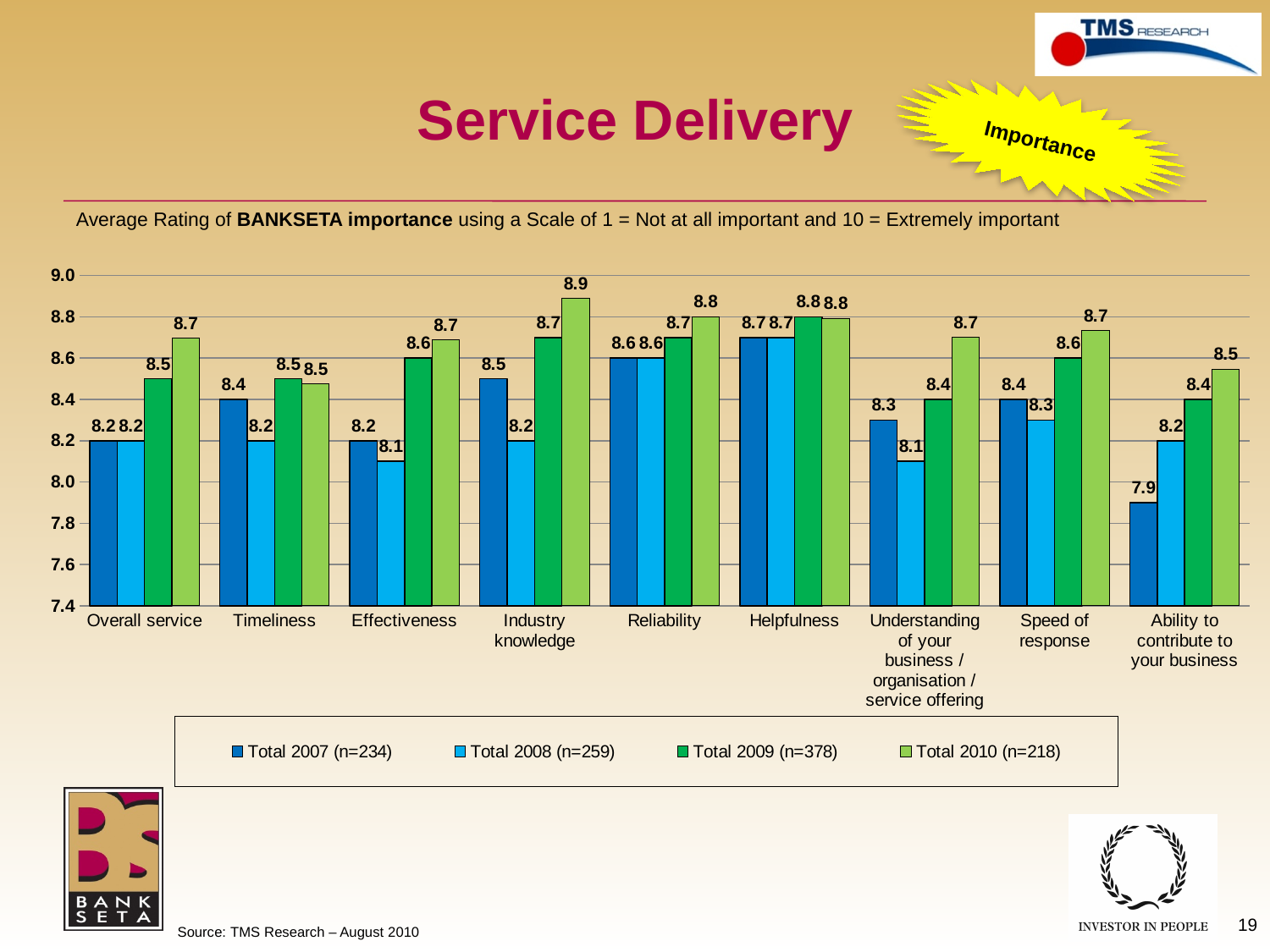
Which category has the highest Total 2010 (n=218) rating? Industry knowledge What is the sample size shown in the legend for Total 2009? n=378 What is the Total 2007 (n=234) rating for Ability to contribute to your business? 7.9 How many series does the legend list? 4 Which is larger for Effectiveness: the Total 2009 (n=378) rating or the Total 2008 (n=259) rating? Total 2009 (n=378) What is the difference between the Total 2010 (n=218) and Total 2007 (n=234) ratings for Ability to contribute to your business? 0.6 What is the Total 2010 (n=218) rating for Industry knowledge? 8.9 Which category has the lowest Total 2007 (n=234) rating? Ability to contribute to your business What type of chart is shown on the slide? bar chart How many categories are shown on the x axis? 9 What is the Total 2008 (n=259) rating for Understanding of your business / organisation / service offering? 8.1 Is the Total 2007 (n=234) rating for Ability to contribute to your business greater or less than 8.0? less